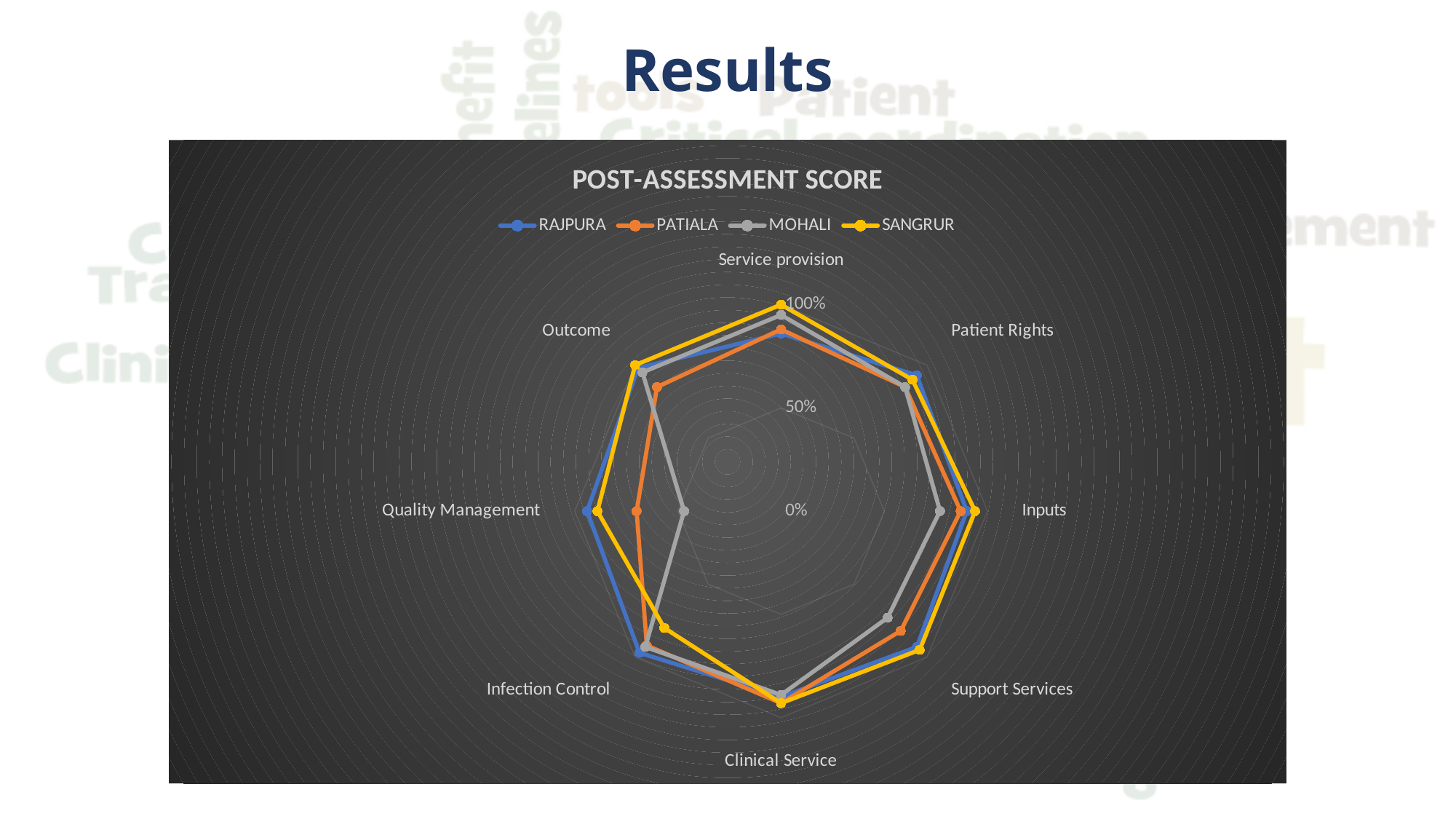
Is the value for RAJPURA on Quality Management greater or less than 50%? greater What is the title of the chart? POST-ASSESSMENT SCORE Is the value for SANGRUR on Service provision greater or less than 50%? greater How many series does the legend list? 4 On Support Services, which is larger: the value for SANGRUR or the value for MOHALI? SANGRUR On Quality Management, which is larger: the value for RAJPURA or the value for MOHALI? RAJPURA What kind of chart is shown on the slide? Radar chart Which series are listed in the legend? RAJPURA, PATIALA, MOHALI, SANGRUR Is the value for MOHALI on Support Services greater or less than 50%? greater Which series has the lowest value on Quality Management? MOHALI Which series has the lowest value on Support Services? MOHALI How many categories (axes) does the radar chart have? 8